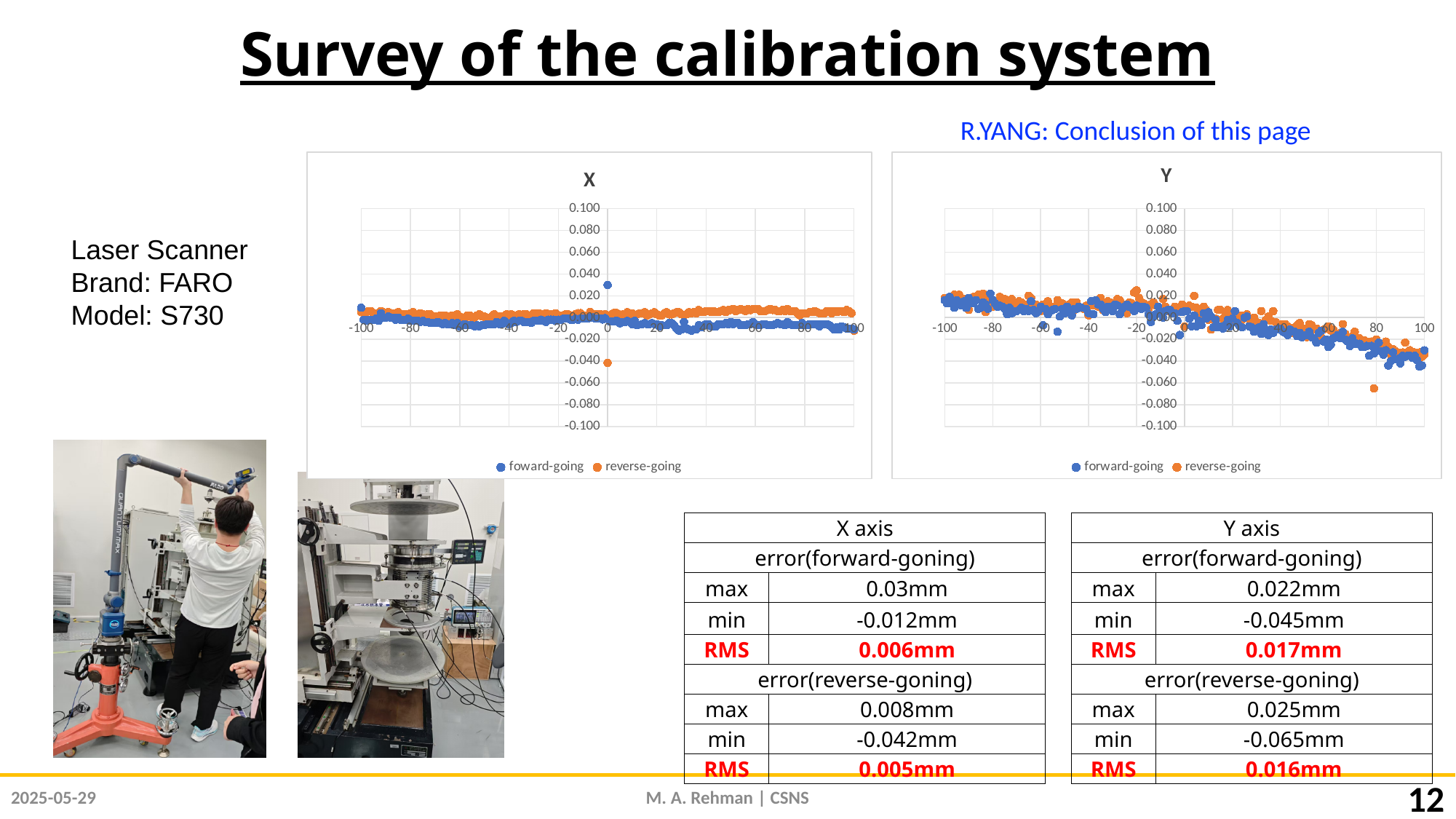
What kind of chart is the chart titled "X"? scatter chart In the chart titled "Y", is the forward-going value at x = -100 greater or less than 0.000? greater What is the highest value shown on the vertical axis of the chart titled "X"? 0.100 What are the two legend entries of the chart titled "Y"? forward-going and reverse-going In the chart titled "Y", is the forward-going value at x = 100 greater or less than -0.080? greater In the chart titled "X", is the forward-going value at x = 100 greater or less than -0.060? greater How many series does the legend of the chart titled "X" list? 2 In the chart titled "Y", do the plotted values rise or fall as the x axis goes from -100 to 100? fall What kind of chart is the chart titled "Y"? scatter chart How many series does the legend of the chart titled "Y" list? 2